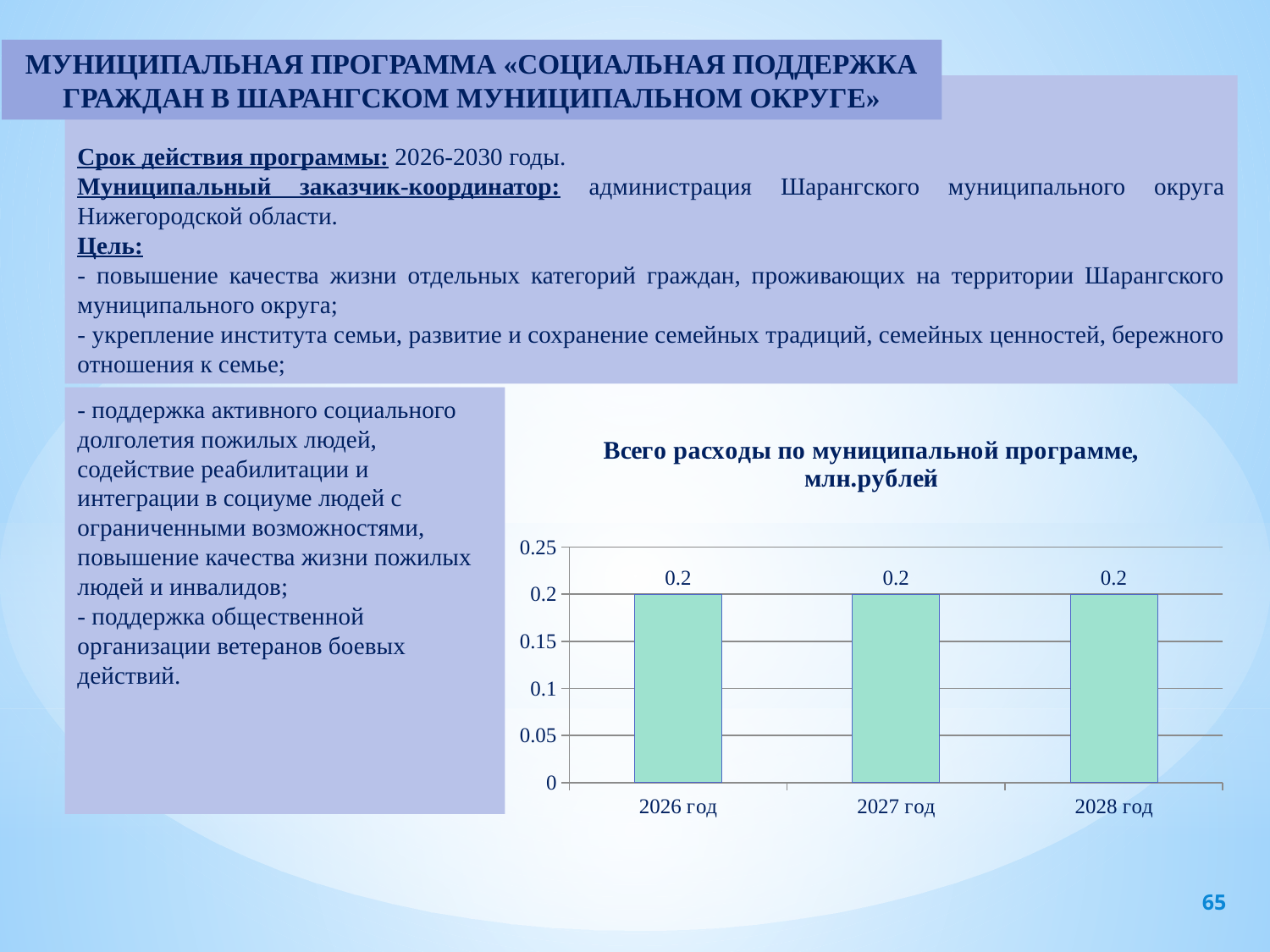
What is the highest value shown on the chart's vertical axis? 0.25 What is the value for 2028 год in the chart? 0.2 Is the value for 2027 год greater or less than 0.15? greater What is the title of the chart? Всего расходы по муниципальной программе, млн.рублей What is the value for 2026 год in the chart? 0.2 What kind of chart is shown on the slide? bar chart Do the values rise, fall, or stay the same from 2026 год to 2028 год? stay the same What is the difference between the values for 2026 год and 2028 год? 0 What is the value for 2027 год in the chart? 0.2 How many categories (years) are shown on the x axis of the chart? 3 Is the value for 2028 год greater or less than 0.25? less